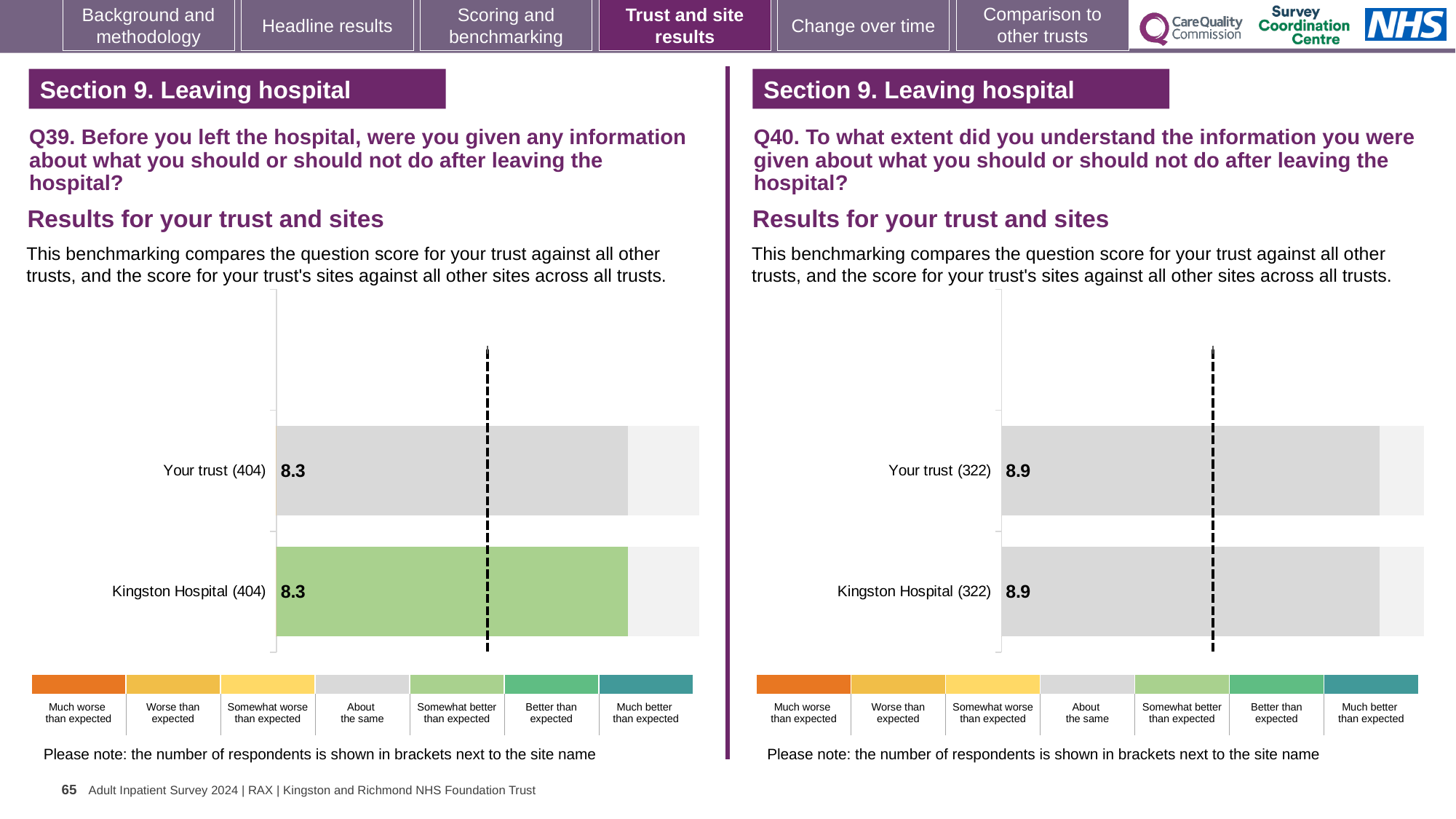
On the Q39 chart (left), what is the difference between the score for Your trust and the score for Kingston Hospital? 0 On the Q39 chart (left), how many respondents are shown in brackets next to Kingston Hospital? 404 How many charts are shown on the slide? 2 On the Q40 chart (right), what is the score for Kingston Hospital? 8.9 On the Q39 chart (left), which benchmark category does the colour of the Kingston Hospital bar correspond to? Somewhat better than expected What type of chart is used on the Q39 chart (left)? Bar chart On the Q40 chart (right), how many bars are plotted? 2 On the Q40 chart (right), how many respondents are shown in brackets next to Your trust? 322 On the Q39 chart (left), what is the score for Kingston Hospital? 8.3 On the Q40 chart (right), which benchmark category does the colour of the Kingston Hospital bar correspond to? About the same On the Q40 chart (right), what is the score for Your trust? 8.9 On the Q39 chart (left), what is the score for Your trust? 8.3